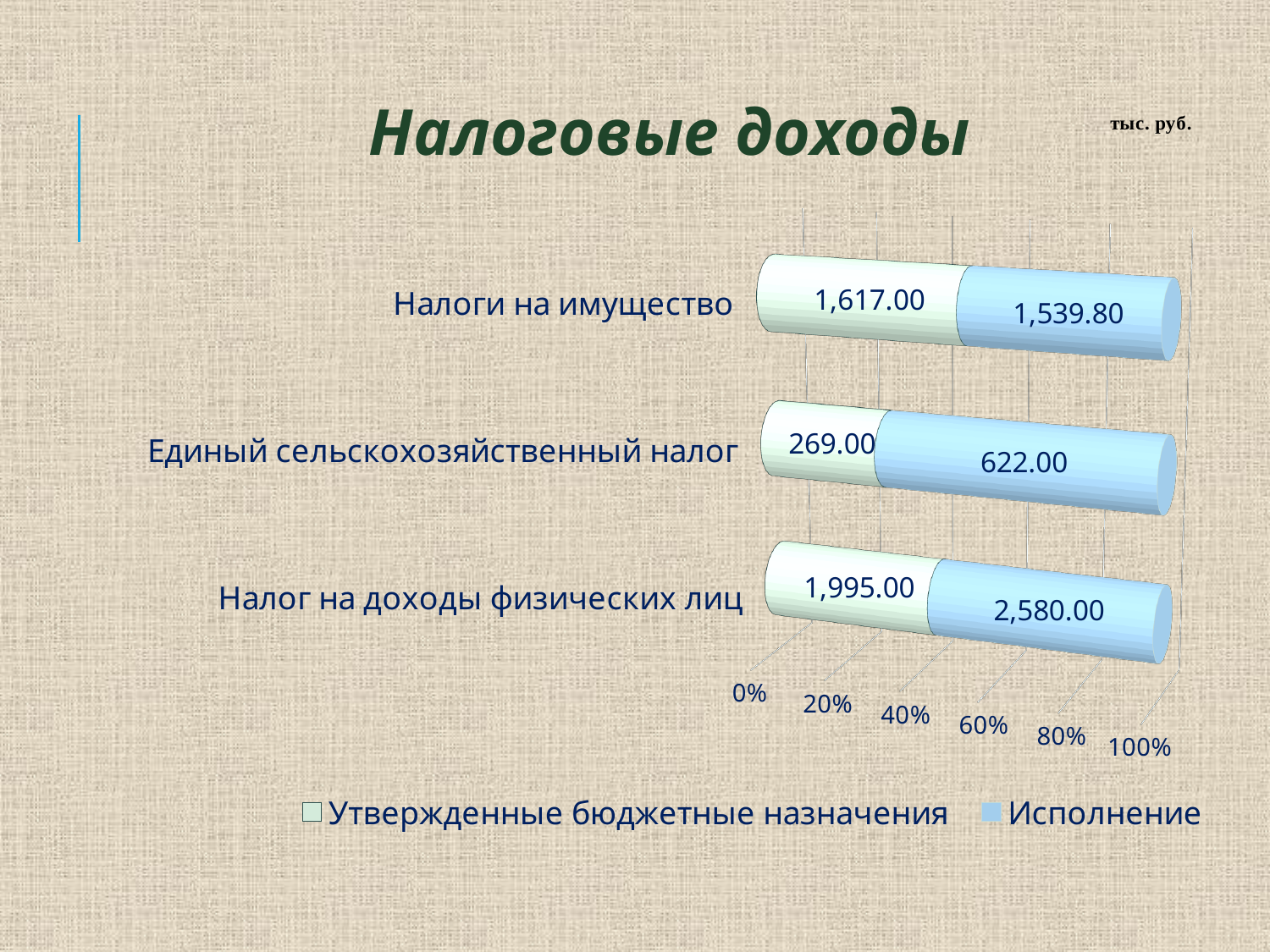
For Налоги на имущество, which is larger: Утвержденные бюджетные назначения or Исполнение? Утвержденные бюджетные назначения What is the difference between Исполнение and Утвержденные бюджетные назначения for Единый сельскохозяйственный налог? 353.00 What is the value of Исполнение for Единый сельскохозяйственный налог? 622.00 Which category has the lowest Утвержденные бюджетные назначения value? Единый сельскохозяйственный налог What is the difference between Исполнение and Утвержденные бюджетные назначения for Налог на доходы физических лиц? 585.00 How many series does the legend list? 2 What is the value of Исполнение for Налог на доходы физических лиц? 2,580.00 What is the value of Утвержденные бюджетные назначения for Налоги на имущество? 1,617.00 Which category has the highest Исполнение value? Налог на доходы физических лиц What is the title of the chart? Налоговые доходы How many categories are shown in the chart? 3 What kind of chart is shown on the slide? Bar chart